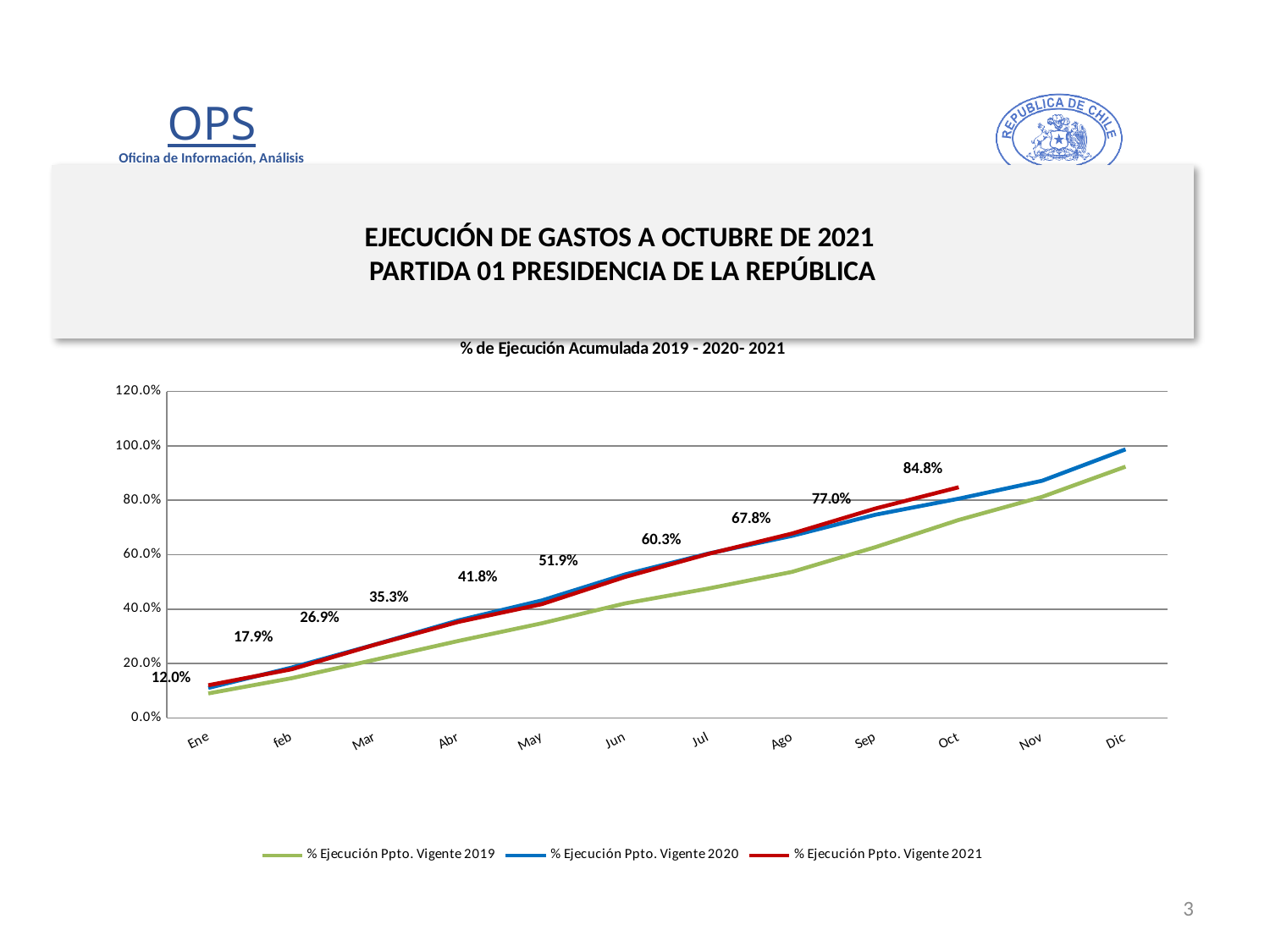
What type of chart is shown on the slide? Line chart What is the value for % Ejecución Ppto. Vigente 2021 in Ene? 12.0% How many series does the legend list? 3 What is the value for % Ejecución Ppto. Vigente 2021 in Jun? 51.9% What is the title of the chart? % de Ejecución Acumulada 2019 - 2020- 2021 What is the difference between the 2021 values for Sep and Ago? 9.2% In which month does the % Ejecución Ppto. Vigente 2021 series reach its highest labelled value? Oct Is the value for % Ejecución Ppto. Vigente 2020 in Dic greater or less than 80.0%? greater What is the value for % Ejecución Ppto. Vigente 2021 in Oct? 84.8% Do the values of the % Ejecución Ppto. Vigente 2021 series rise or fall from Ene to Oct? Rise How many months are shown on the x axis? 12 In Dic, which series is higher: % Ejecución Ppto. Vigente 2019 or % Ejecución Ppto. Vigente 2020? % Ejecución Ppto. Vigente 2020